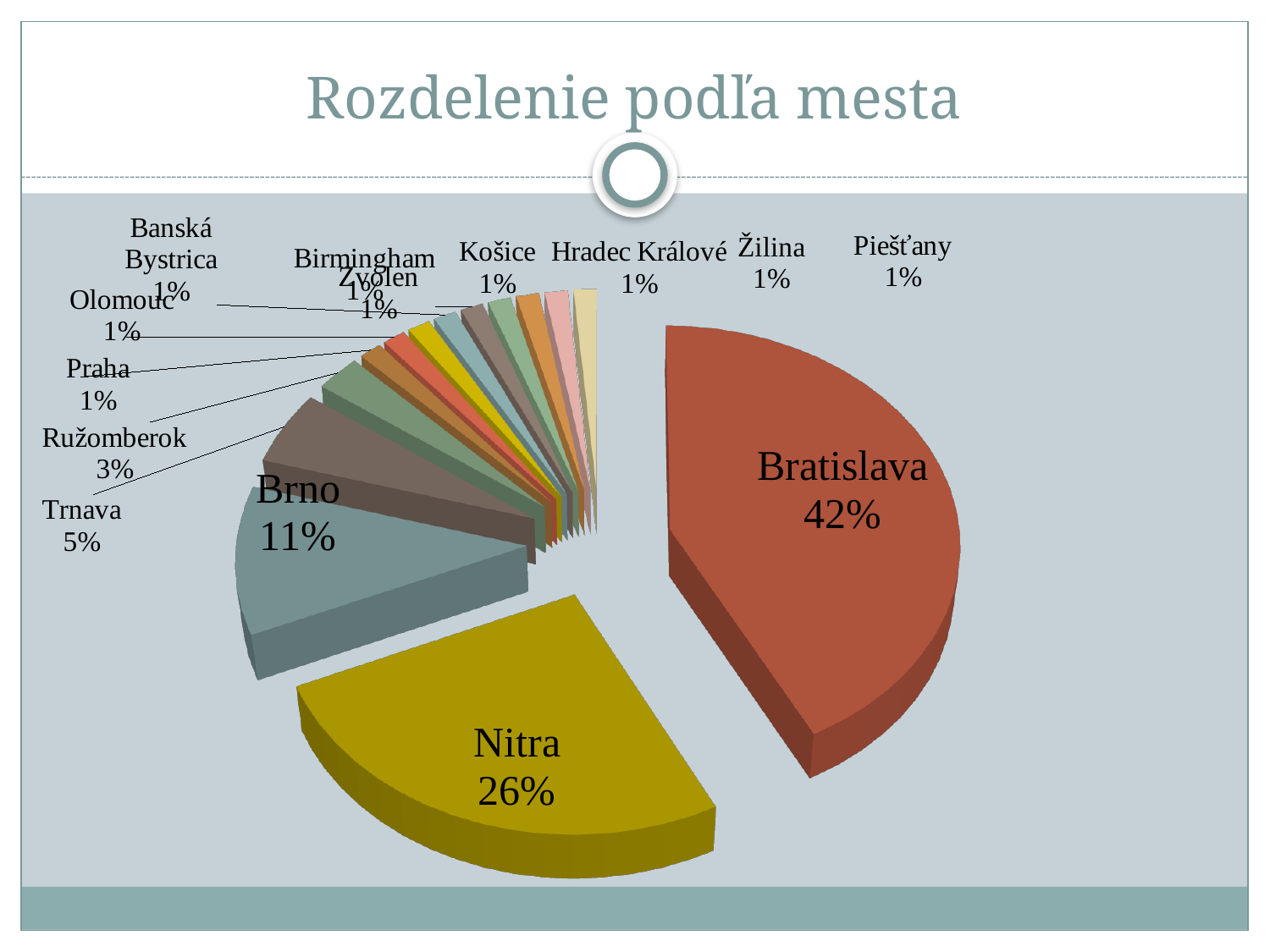
What share of the pie does Košice have? 1% What is the difference in percentage points between Bratislava and Nitra? 16 What is the title of the chart? Rozdelenie podľa mesta Which is larger, the slice for Nitra or the slice for Brno? Nitra What share of the pie does Bratislava have? 42% What is the difference in percentage points between Brno and Trnava? 6 What share of the pie does Brno have? 11% What kind of chart is shown on the slide? pie chart Which city has the largest slice of the pie? Bratislava What share of the pie does Nitra have? 26% What share of the pie does Ružomberok have? 3% What share of the pie does Trnava have? 5%